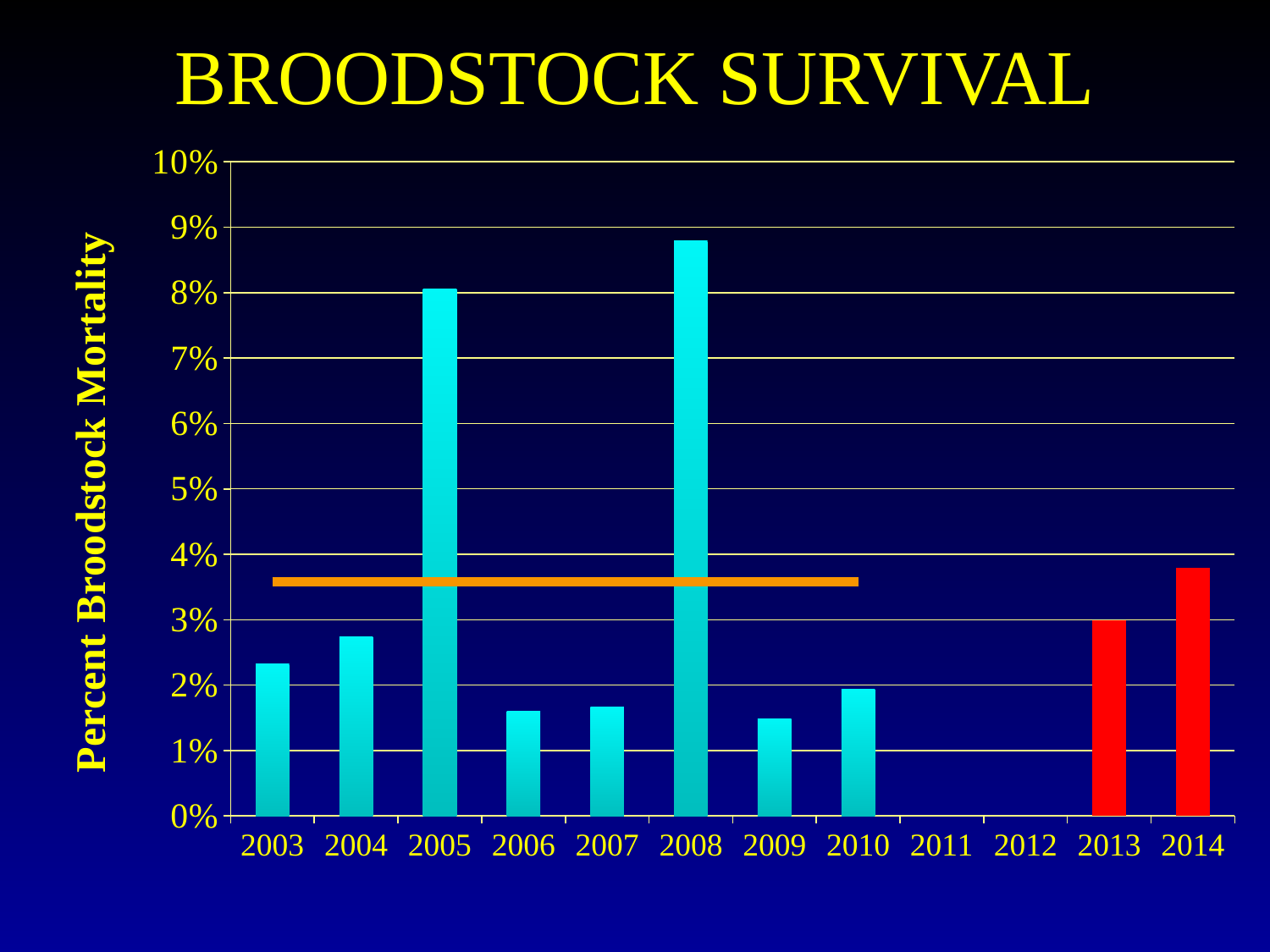
Is the value for 2008 greater or less than 8%? greater Is the value for 2006 greater or less than 2%? less Is the value for 2003 greater or less than 3%? less What is the title of the chart? BROODSTOCK SURVIVAL Which is larger, the value for 2005 or the value for 2008? 2008 What kind of chart is shown on the slide? Bar chart What colour are the bars for 2013 and 2014? Red How many year labels are shown on the x axis? 12 Which is larger, the value for 2013 or the value for 2014? 2014 Which year has the highest percent broodstock mortality? 2008